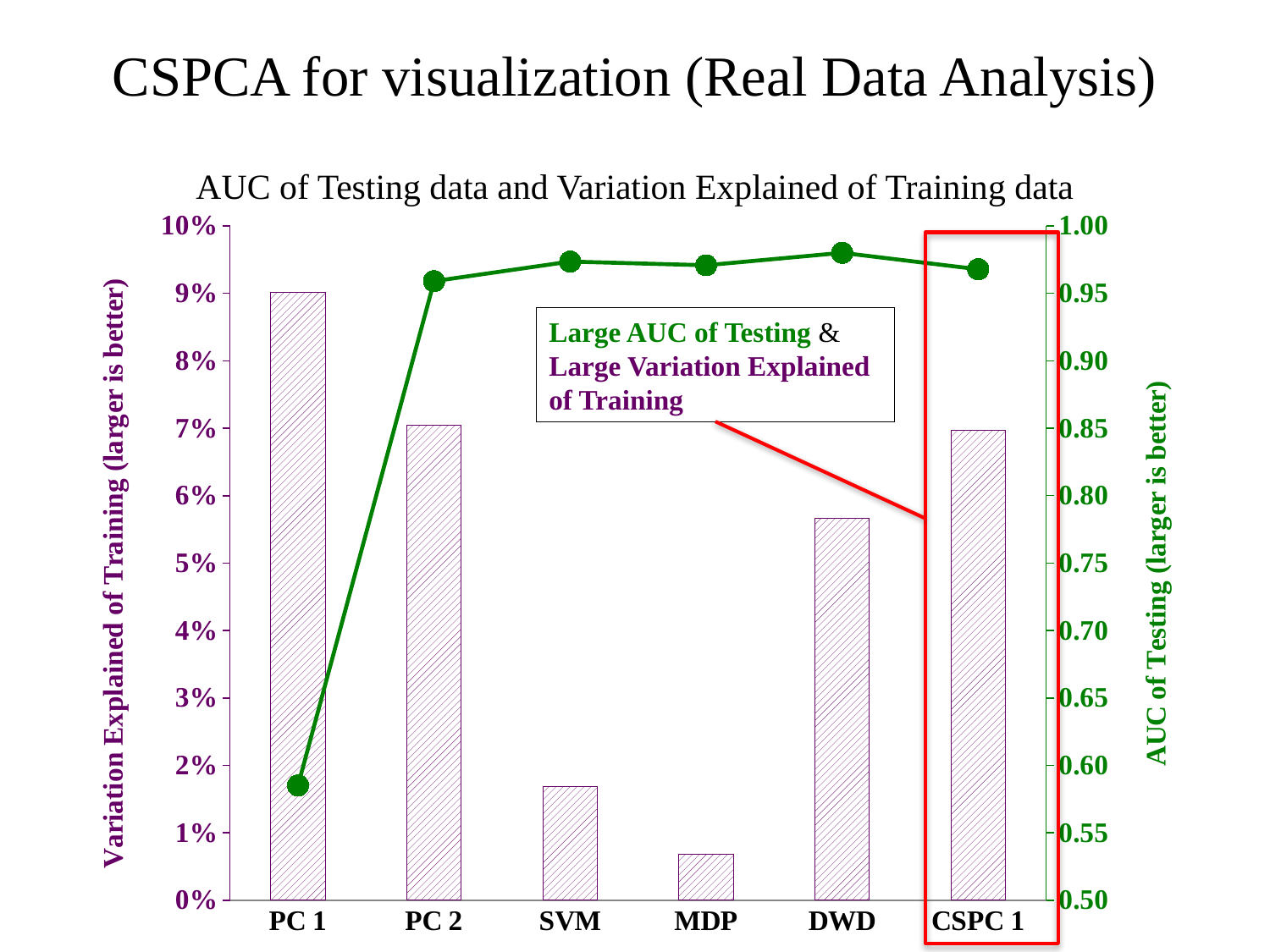
Which category has the highest Variation Explained of Training bar? PC 1 What is the title of the chart? AUC of Testing data and Variation Explained of Training data Is the Variation Explained of Training for SVM greater or less than 2%? less Which has a larger Variation Explained of Training bar, PC 1 or DWD? PC 1 How many categories are shown on the x axis of the chart? 6 Is the Variation Explained of Training for DWD greater or less than 5%? greater What kind of chart is shown on the slide? Combined bar and line chart Is the AUC of Testing for PC 1 greater or less than 0.60? less Which category has the lowest AUC of Testing value on the line? PC 1 Which category has the lowest Variation Explained of Training bar? MDP What is the label of the right-hand vertical axis? AUC of Testing (larger is better)